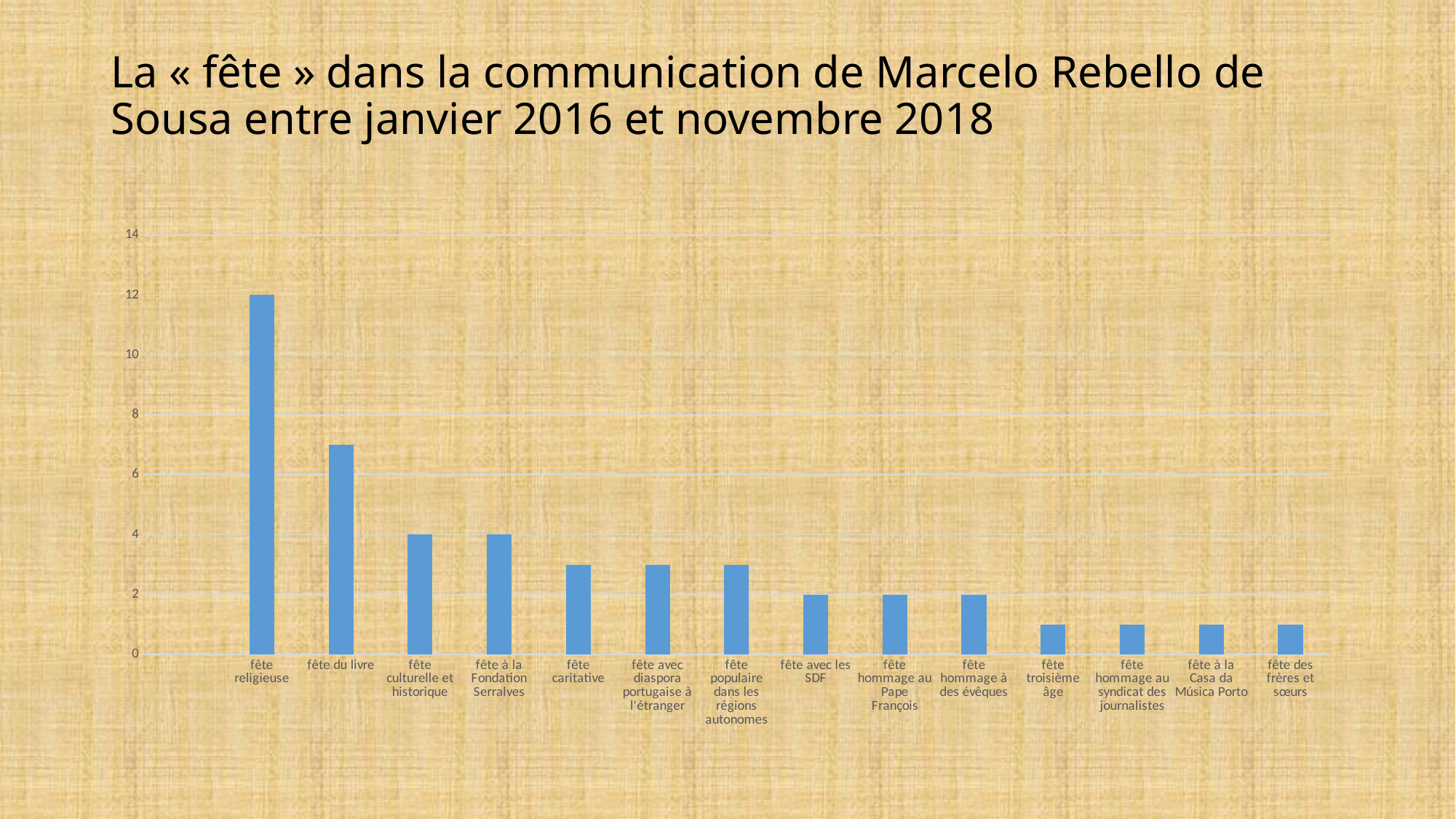
What is the value for fête culturelle et historique? 4 What is the value for fête avec les SDF? 2 Which category has the highest value? fête religieuse Is the value for fête troisième âge greater or less than 2? less What is the difference between the value for fête religieuse and the value for fête à la Fondation Serralves? 8 What kind of chart is shown on the slide? bar chart Is the value for fête du livre greater or less than 6? greater Which is larger, the value for fête religieuse or the value for fête du livre? fête religieuse How many categories are plotted on the chart? 14 What is the value for fête religieuse? 12 Do the values rise or fall from left to right along the x axis? fall Is the value for fête caritative greater or less than 4? less